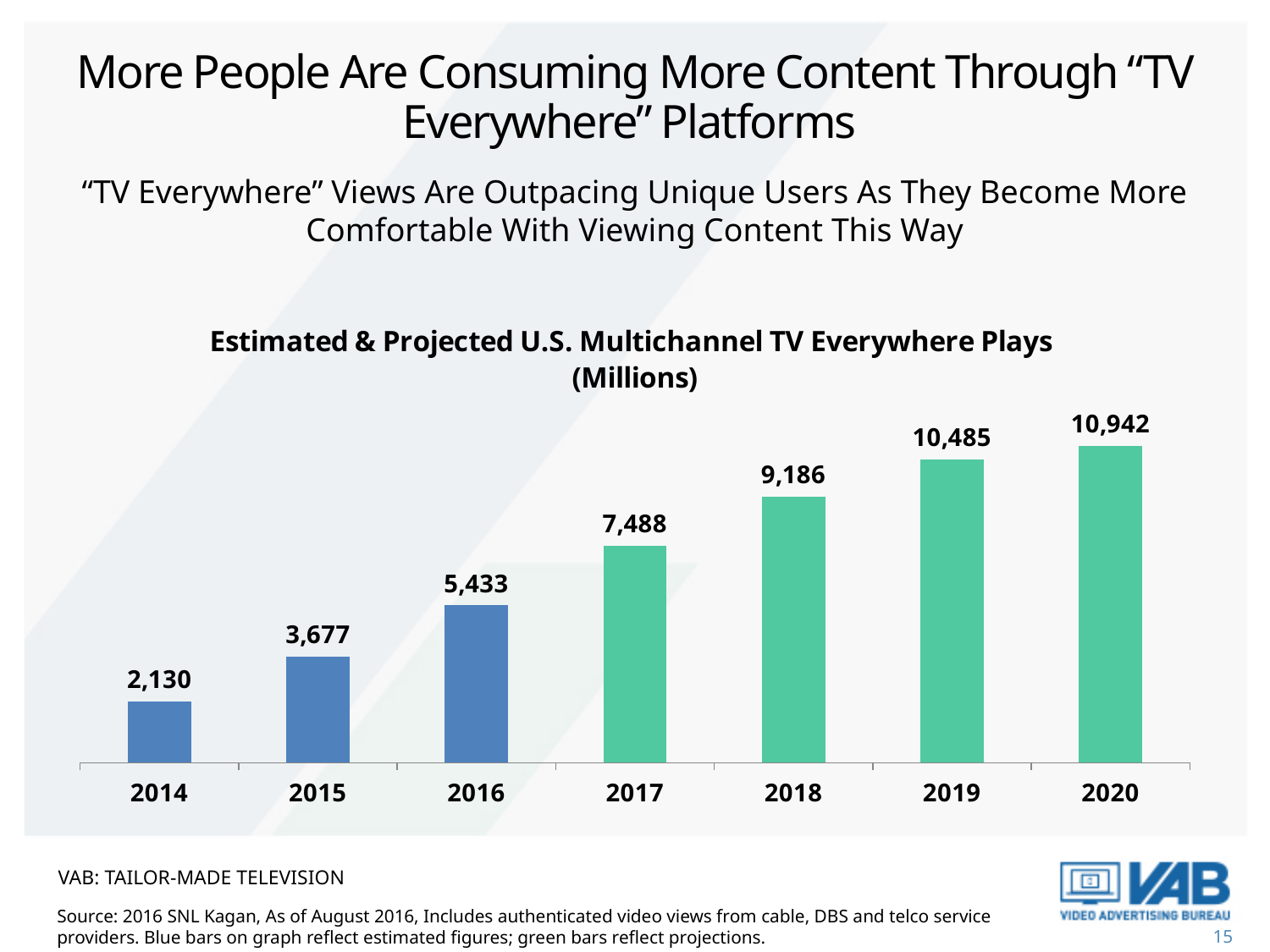
What is the value for 2014? 2,130 How many years are shown on the x axis? 7 Which is larger, the value for 2018 or the value for 2017? 2018 Which year has the highest value? 2020 Do the values rise or fall from 2014 to 2020? rise Which year has the lowest value? 2014 What is the value for 2020? 10,942 What is the difference between the values for 2016 and 2015? 1,756 What is the value for 2017? 7,488 What kind of chart is shown? bar chart What is the difference between the values for 2020 and 2019? 457 What is the title of the chart? Estimated & Projected U.S. Multichannel TV Everywhere Plays (Millions)